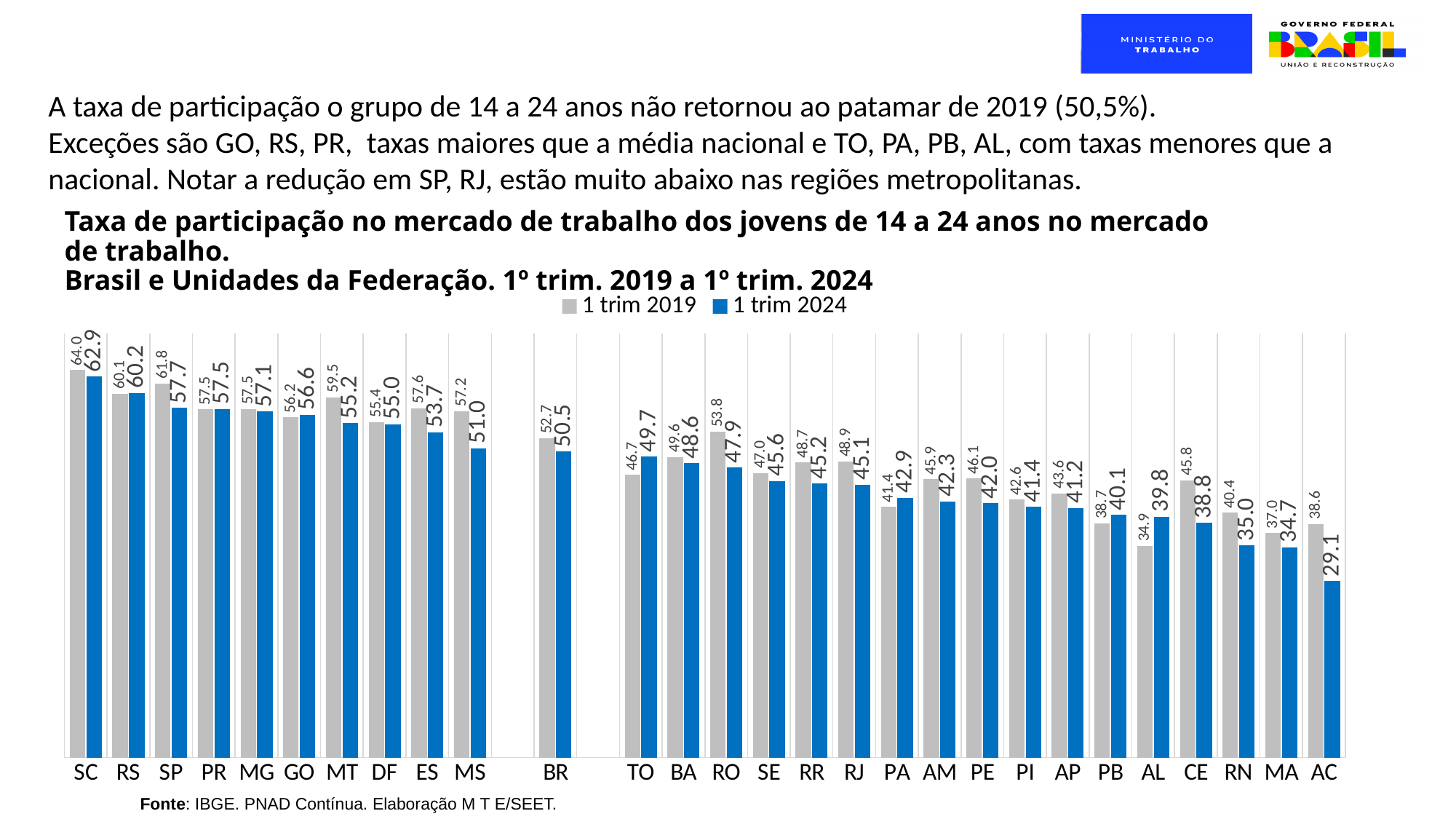
Which colour represents the 1 trim 2024 series? Blue What is the difference between the 1 trim 2019 and 1 trim 2024 values for AC? 9.5 What is the value for SC in the 1 trim 2024 series? 62.9 What is the difference between the 1 trim 2019 and 1 trim 2024 values for SP? 4.1 What is the value for BR in the 1 trim 2019 series? 52.7 What is the value for AC in the 1 trim 2024 series? 29.1 Which category has the highest value in the 1 trim 2024 series? SC How many series does the legend list? 2 Which category has the lowest value in the 1 trim 2019 series? AL How many categories are shown on the x axis? 28 Which is larger for TO: the 1 trim 2019 value or the 1 trim 2024 value? 1 trim 2024 What kind of chart is shown on the slide? Bar chart